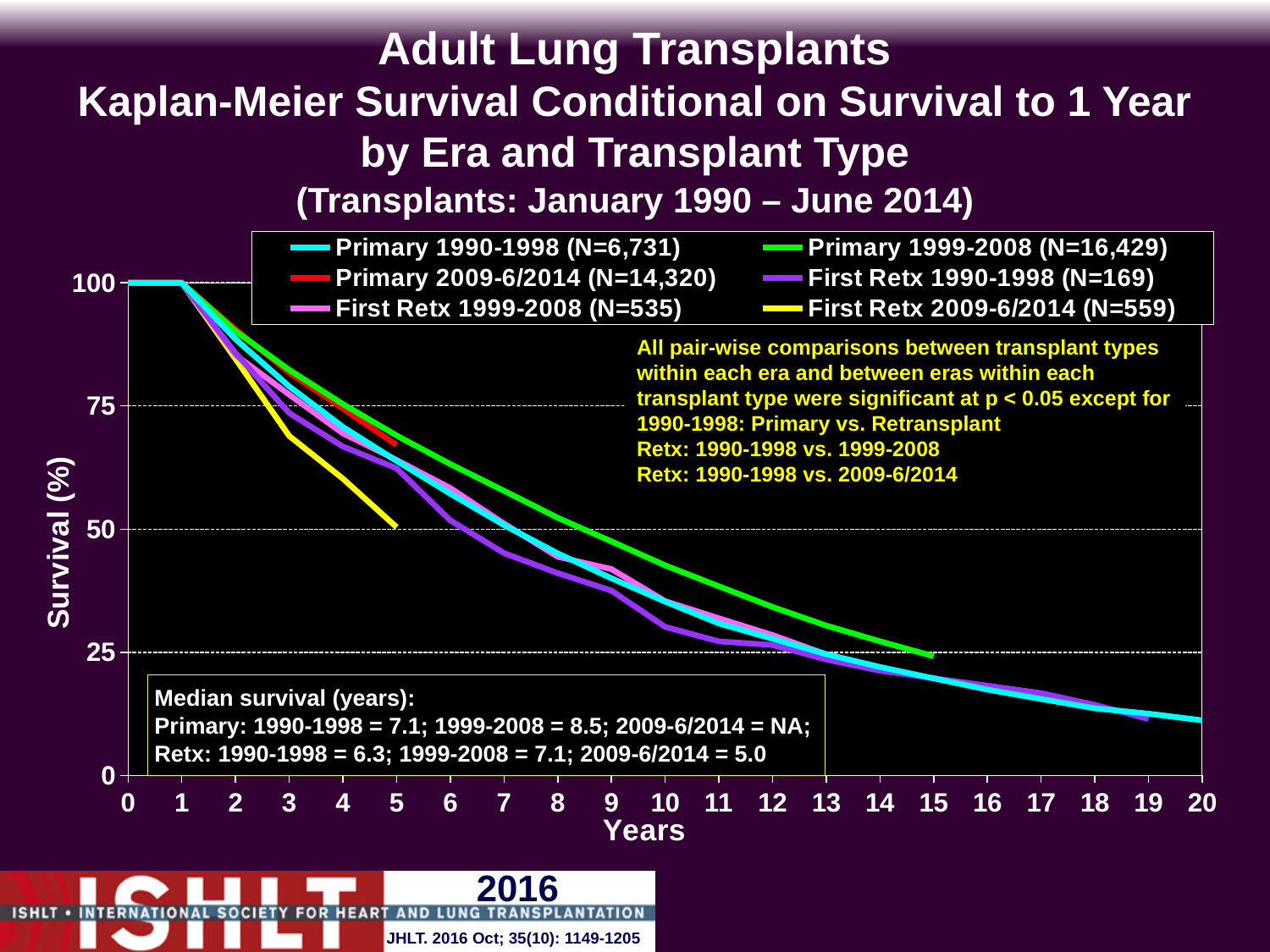
What is the median survival in years for Primary transplants in 1999-2008? 8.5 What is the difference in median survival (years) between Primary 1999-2008 and Primary 1990-1998? 1.4 Is the survival value for First Retx 2009-6/2014 at year 3 greater or less than 75? less Which has a larger median survival: Retx 1990-1998 or Retx 1999-2008? Retx 1999-2008 Is the survival value for Primary 1990-1998 at year 20 greater or less than 25? less What is the N shown in the legend for Primary 1999-2008? 16,429 Which group has the highest median survival listed in the text box? Primary 1999-2008 What kind of chart is shown on the slide? line chart Which group has the lowest median survival listed in the text box? Retx 2009-6/2014 How many series does the legend list? 6 What is the median survival in years for Retx (retransplant) in 2009-6/2014? 5.0 Do the survival curves rise or fall as years increase along the x axis? fall